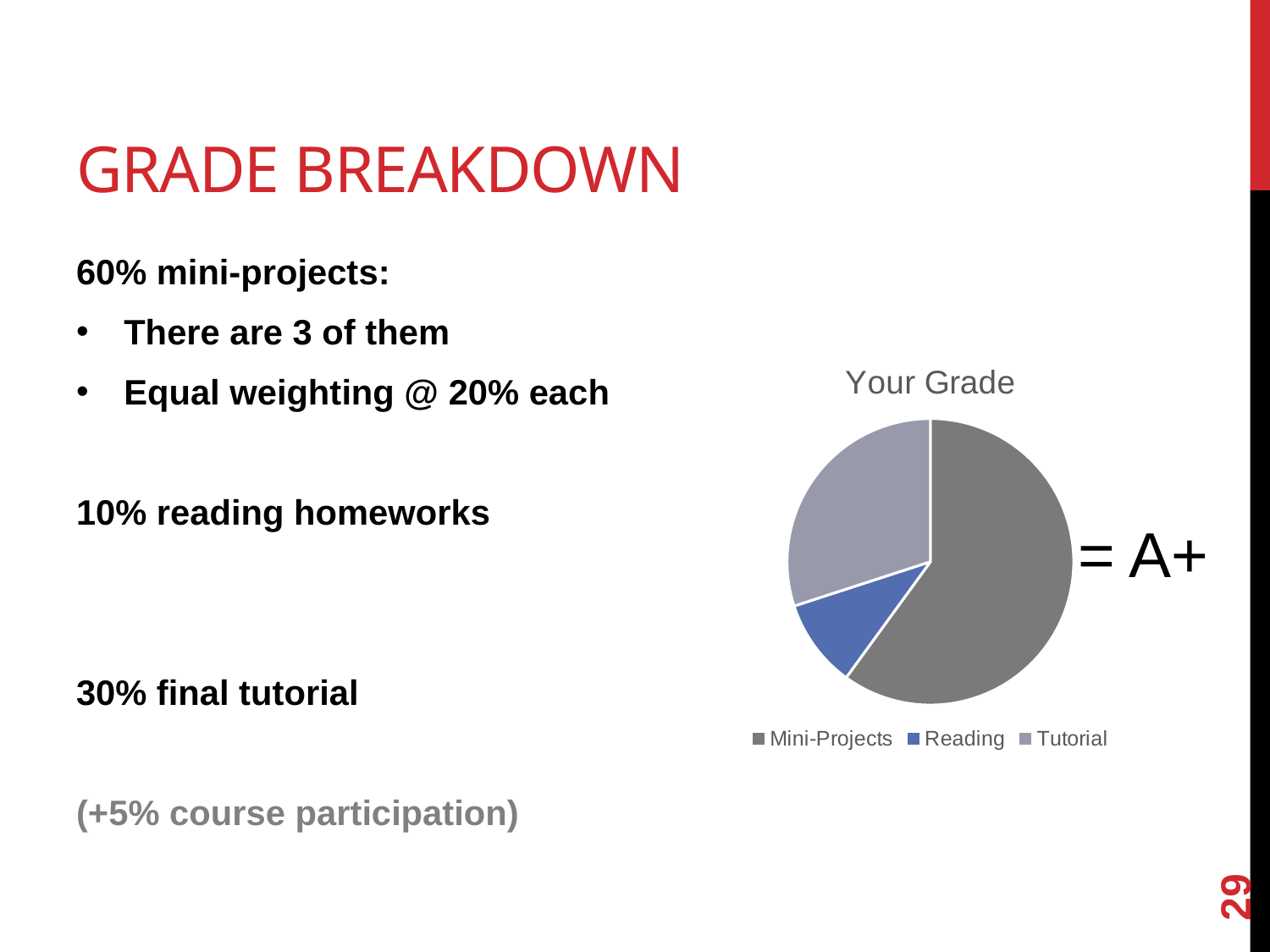
Which slice is larger, Tutorial or Reading? Tutorial What kind of chart is shown on the slide? Pie chart Which category has the largest slice of the pie? Mini-Projects What is the title of the chart? Your Grade Which slice is larger, Mini-Projects or Tutorial? Mini-Projects What colour is the Reading slice in the pie chart? Blue How many entries does the chart legend list? 3 Which category has the smallest slice of the pie? Reading How many slices does the pie chart have? 3